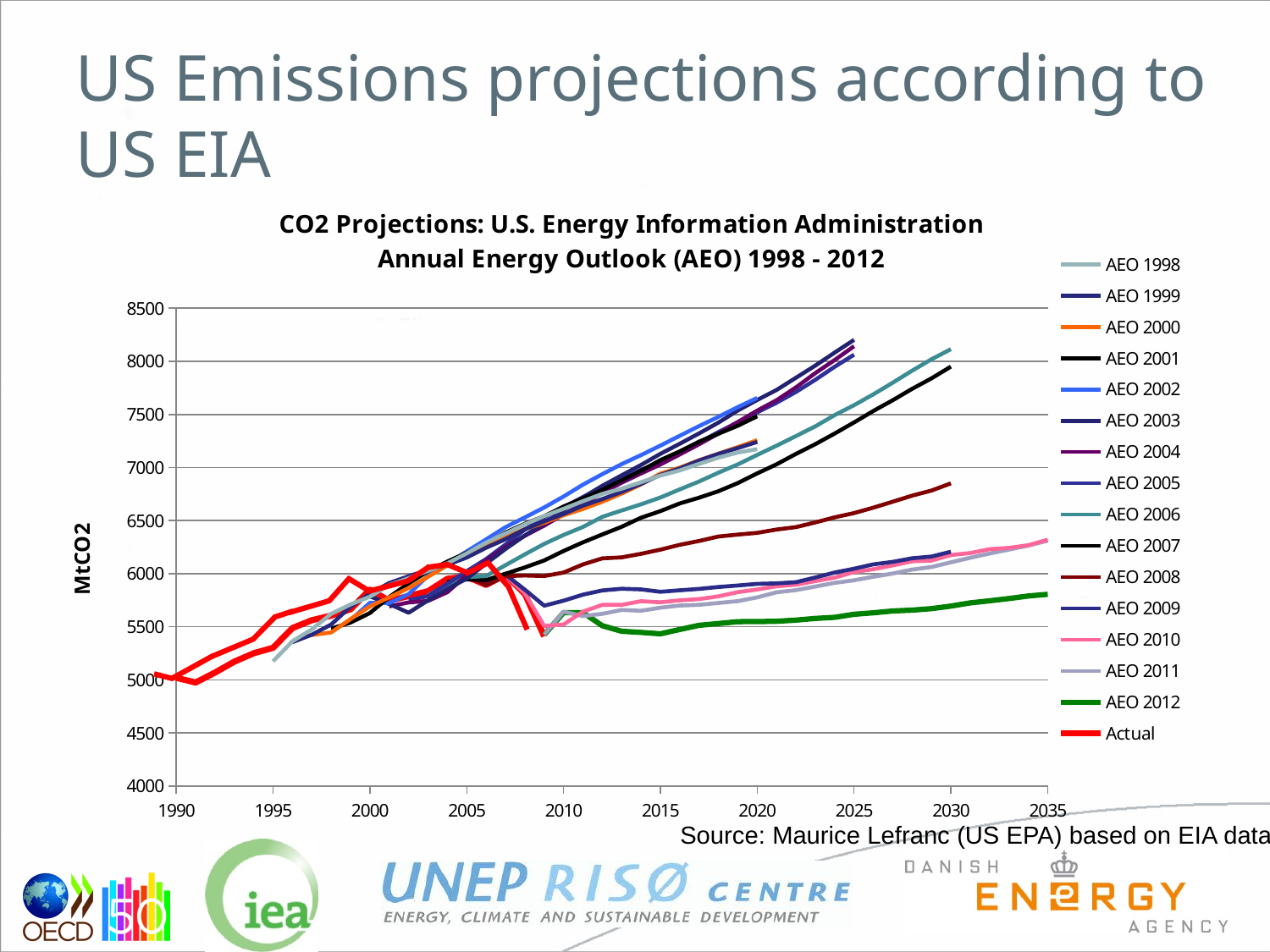
Is the value for AEO 2008 at 2030 greater or less than 6500? greater Is the value for AEO 2010 at 2035 greater or less than 6000? greater Which legend entry is drawn in red? Actual Is the value for AEO 2006 at 2030 greater or less than 7500? greater What kind of chart is shown on the slide? line chart At 2030, which is larger: the value for AEO 2006 or the value for AEO 2012? AEO 2006 How many series does the legend list? 16 Does the Actual series rise or fall between 1990 and 2005? rise Which series has the lowest value at 2035? AEO 2012 What is the label on the y axis of the chart? MtCO2 How many year labels are shown on the x axis? 10